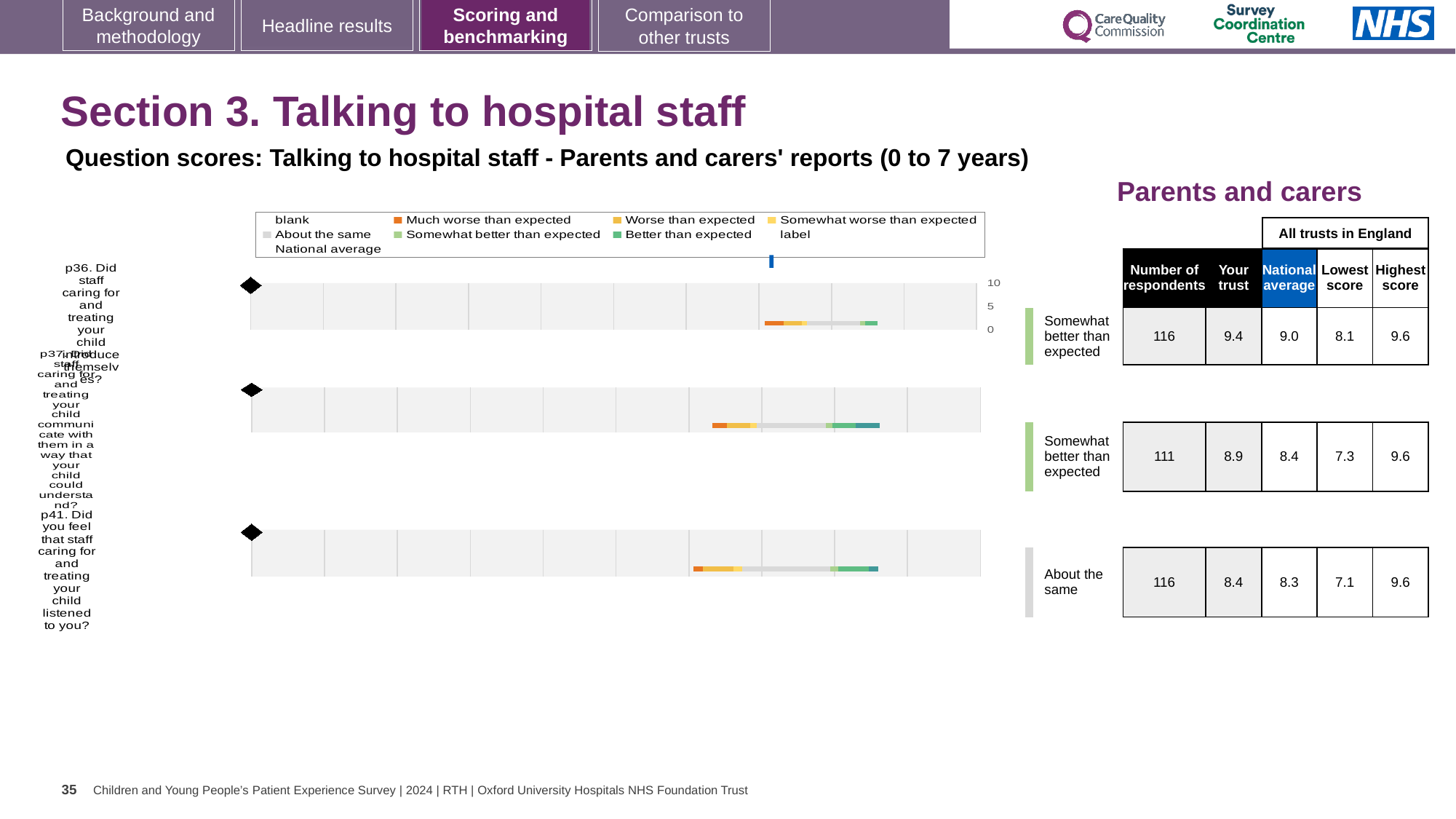
According to the table beside the chart, what is the 'Your trust' score for p36? 9.4 Which question has the highest 'Your trust' score in the table beside the chart? p36 Which question has the lowest 'Your trust' score in the table beside the chart? p41 What is the lowest score across all trusts in England for p41? 7.1 For p37, which is larger: the 'Your trust' score or the national average? Your trust According to the table beside the chart, how many respondents answered p41? 116 How many question bars are plotted in the chart? 3 What is the maximum value shown on the chart's score axis? 10 Which legend entry is shown in dark orange? Much worse than expected What is the difference between the 'Your trust' score and the national average for p36? 0.4 According to the table beside the chart, what is the national average for p37? 8.4 What kind of chart is shown on the slide? bar chart